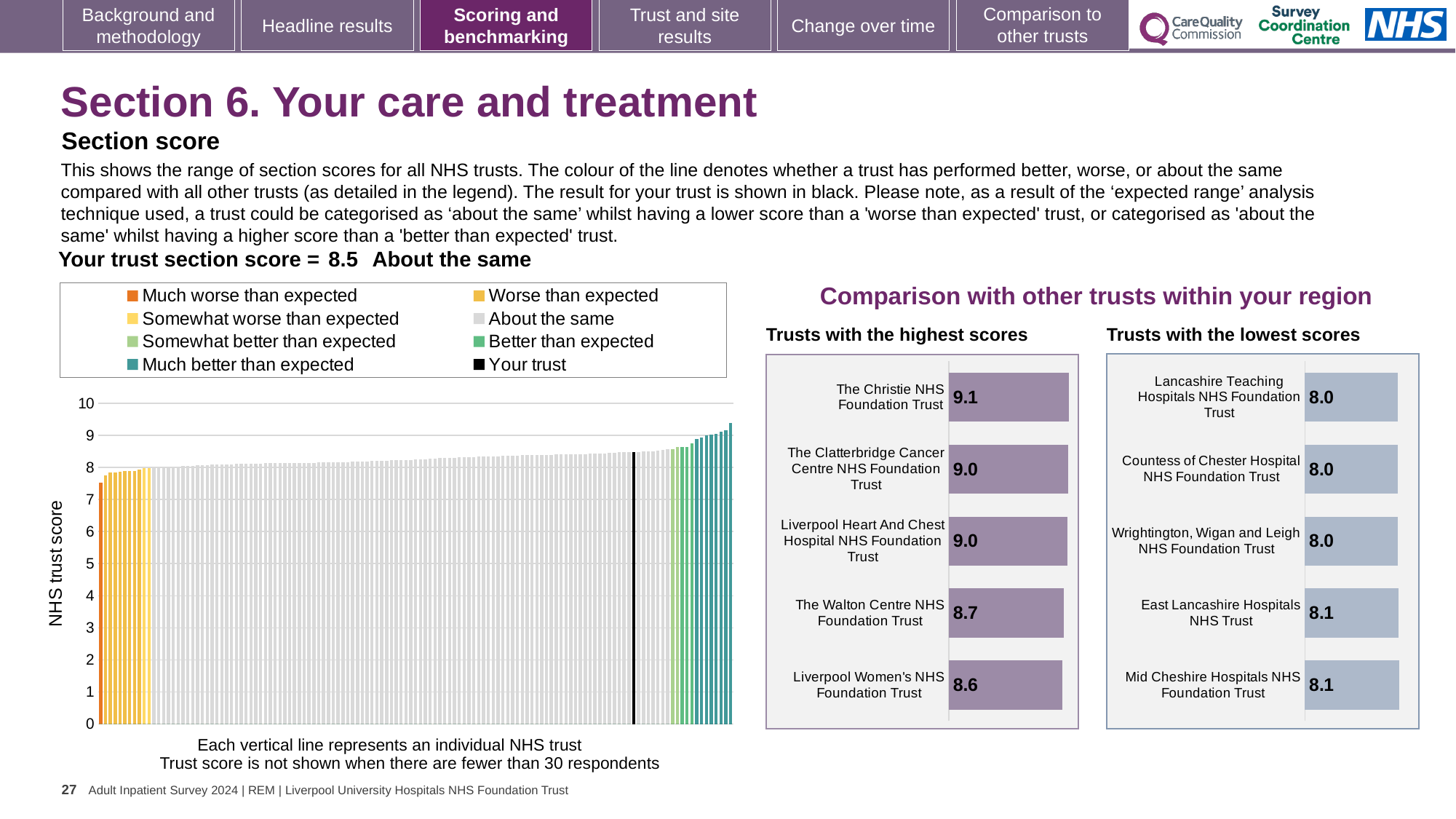
In the 'Trusts with the lowest scores' chart, what is the score for East Lancashire Hospitals NHS Trust? 8.1 In the 'Trusts with the highest scores' chart, which has the larger score: The Walton Centre NHS Foundation Trust or Liverpool Women's NHS Foundation Trust? The Walton Centre NHS Foundation Trust How many entries does the legend of the left-hand NHS trust score chart list? 8 In the 'Trusts with the lowest scores' chart, what is the score for Countess of Chester Hospital NHS Foundation Trust? 8.0 How many trusts are shown in the 'Trusts with the lowest scores' chart? 5 In the left-hand NHS trust score chart, is the value of the lowest-scoring (leftmost) trust greater or less than 8? less What kind of chart is the large chart on the left showing NHS trust scores? Bar chart In the 'Trusts with the highest scores' chart, what is the difference between the scores of The Christie NHS Foundation Trust and Liverpool Women's NHS Foundation Trust? 0.5 In the 'Trusts with the highest scores' chart, which trust has the lowest score? Liverpool Women's NHS Foundation Trust In the 'Trusts with the highest scores' chart, which trust has the highest score? The Christie NHS Foundation Trust In the 'Trusts with the highest scores' chart, what is the score for The Christie NHS Foundation Trust? 9.1 In the 'Trusts with the highest scores' chart, what is the score for The Walton Centre NHS Foundation Trust? 8.7